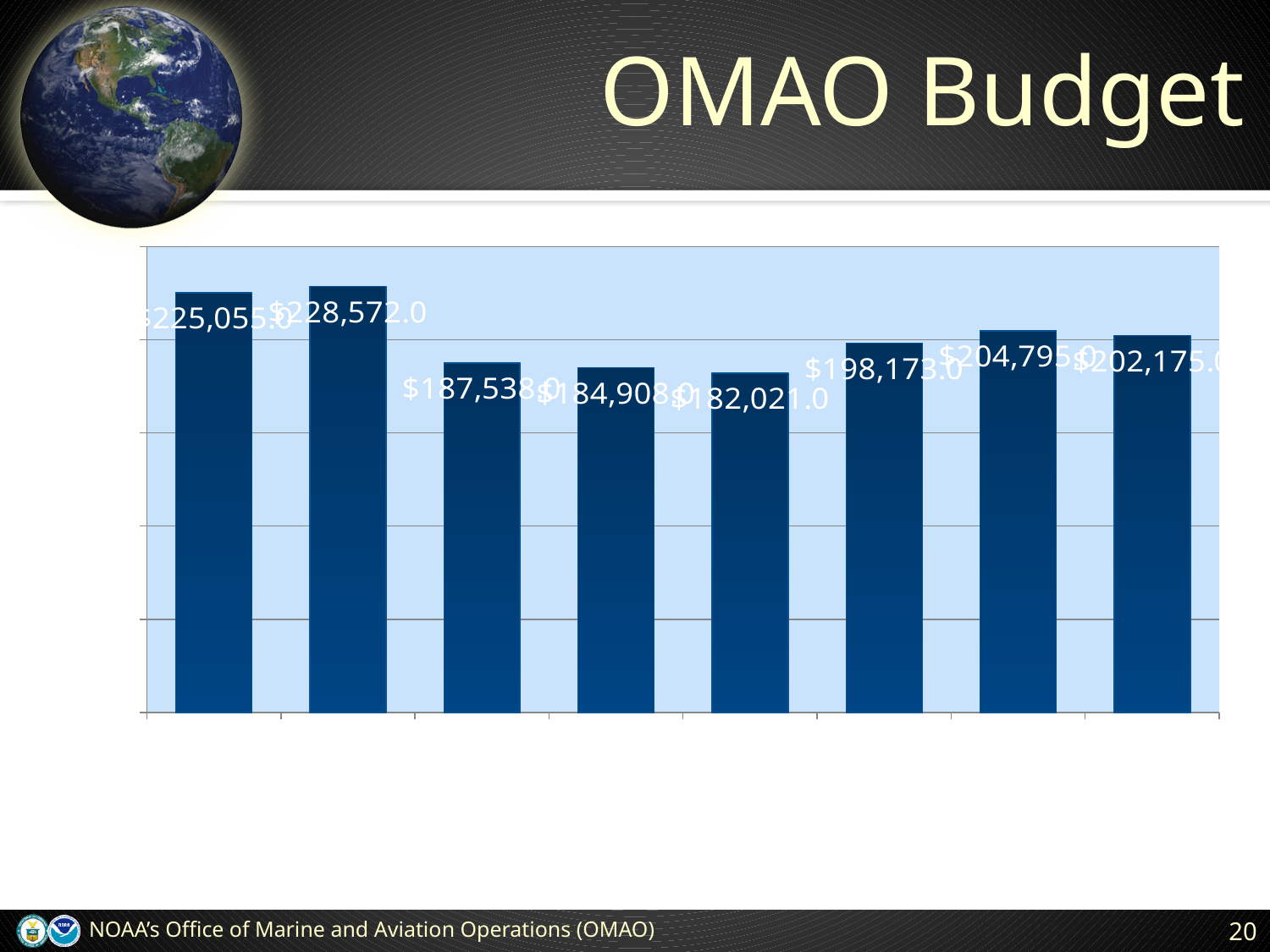
What is the value labelled on the fifth bar from the left? $182,021.0 What is the difference between the highest bar ($228,572.0) and the lowest bar ($182,021.0)? $46,551.0 What is the value labelled on the second bar from the left? $228,572.0 How many bars are plotted in the chart? 8 Which bar has the highest value? the second bar from the left ($228,572.0) Which bar has the lowest value? the fifth bar from the left ($182,021.0) What is the difference between the seventh bar ($204,795.0) and the sixth bar ($198,173.0)? $6,622.0 Which is larger, the value of the sixth bar or the value of the seventh bar? the seventh bar What is the value labelled on the seventh bar from the left? $204,795.0 What kind of chart is shown on the slide? bar chart What is the title shown on the slide above the chart? OMAO Budget What is the value labelled on the sixth bar from the left? $198,173.0